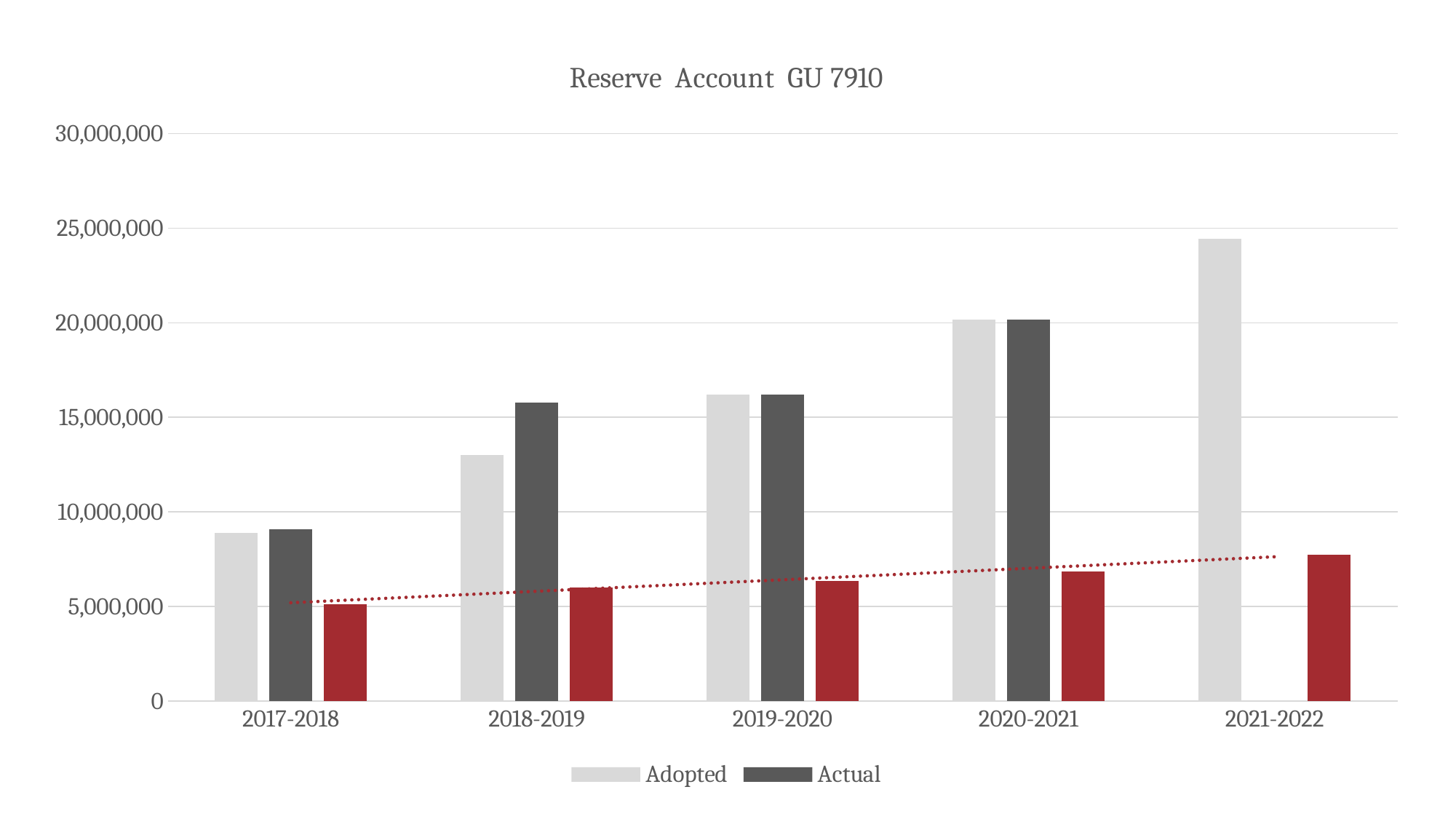
Do the Adopted values rise or fall from 2017-2018 to 2021-2022? Rise Which fiscal year has the highest Adopted value? 2021-2022 How many fiscal year categories are shown on the x axis? 5 How many series does the legend list? 2 What is the title of the chart? Reserve Account GU 7910 For 2018-2019, which is larger, the Adopted value or the Actual value? Actual Is the Actual value for 2017-2018 greater or less than 10,000,000? less What kind of chart is shown on the slide? Bar chart Which fiscal year has the lowest Adopted value? 2017-2018 Is the Adopted value for 2018-2019 greater or less than 15,000,000? less Is the Adopted value for 2021-2022 greater or less than 20,000,000? greater Which fiscal year has the highest Actual value? 2020-2021